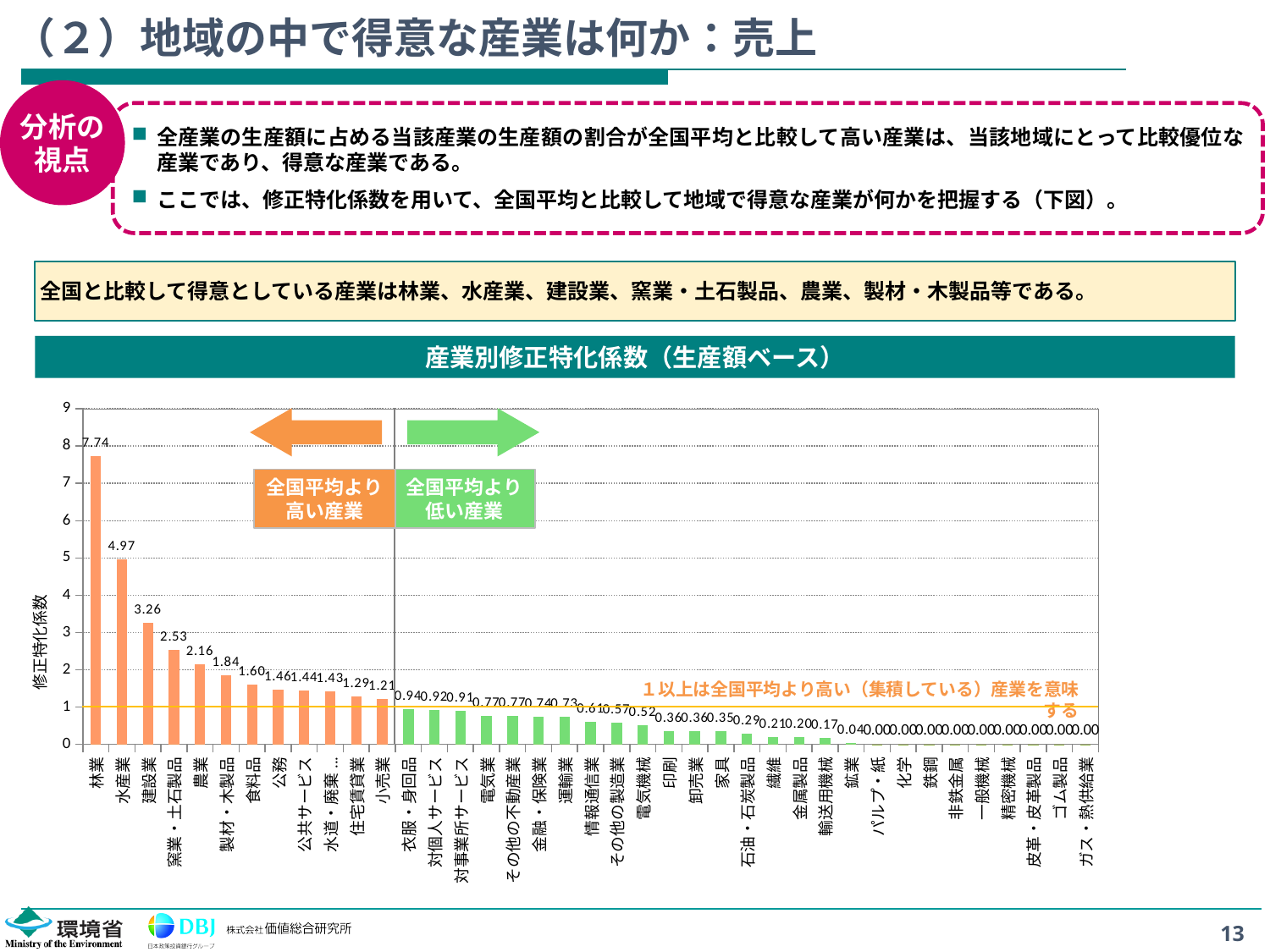
What is the 修正特化係数 value for 林業? 7.74 Which has a larger value, 建設業 or 農業? 建設業 Which industry has the highest 修正特化係数? 林業 What kind of chart is used to show the 産業別修正特化係数? bar chart What is the value shown for 鉱業? 0.04 What is the value shown for 水産業? 4.97 What is the value shown for 建設業? 3.26 How many industries are shown with orange bars (values above the national average)? 12 Is the value for 製材・木製品 greater or less than 1? greater What is the difference between the values for 林業 and 水産業? 2.77 At what value is the horizontal orange reference line drawn on the chart? 1 Do the values rise or fall moving from left to right along the x axis? fall